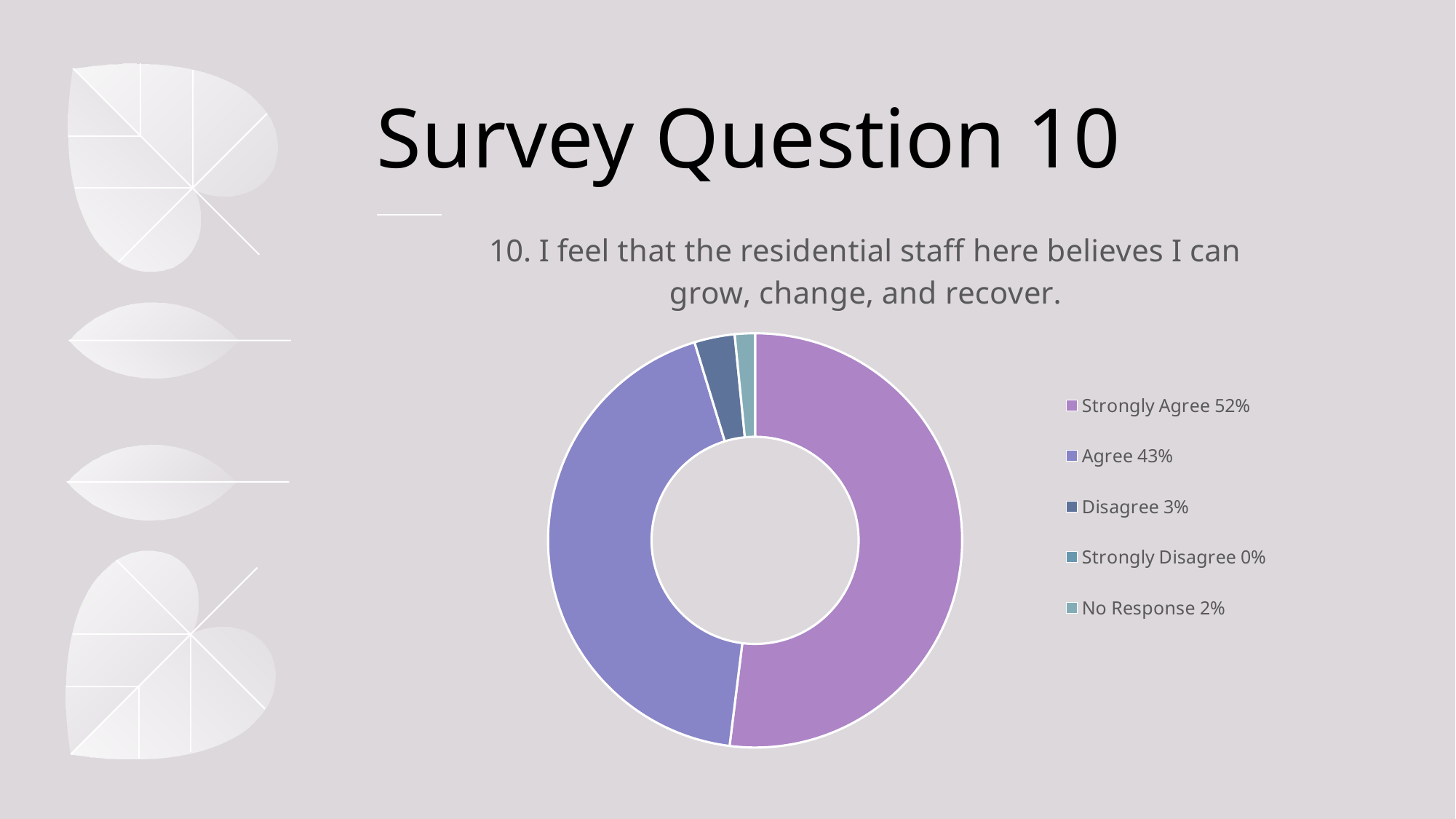
What percentage of respondents answered Strongly Disagree? 0% What is the difference in percentage points between Strongly Agree and Agree? 9 What is the combined share of Strongly Agree and Agree? 95% What percentage of respondents gave No Response? 2% Which is larger, the share for Disagree or the share for No Response? Disagree What percentage of respondents answered Disagree? 3% Which response category has the largest share? Strongly Agree How many response categories does the legend list? 5 What percentage of respondents answered Strongly Agree? 52% Which response category has the smallest share? Strongly Disagree What kind of chart is shown on the slide? Doughnut (pie) chart What percentage of respondents answered Agree? 43%